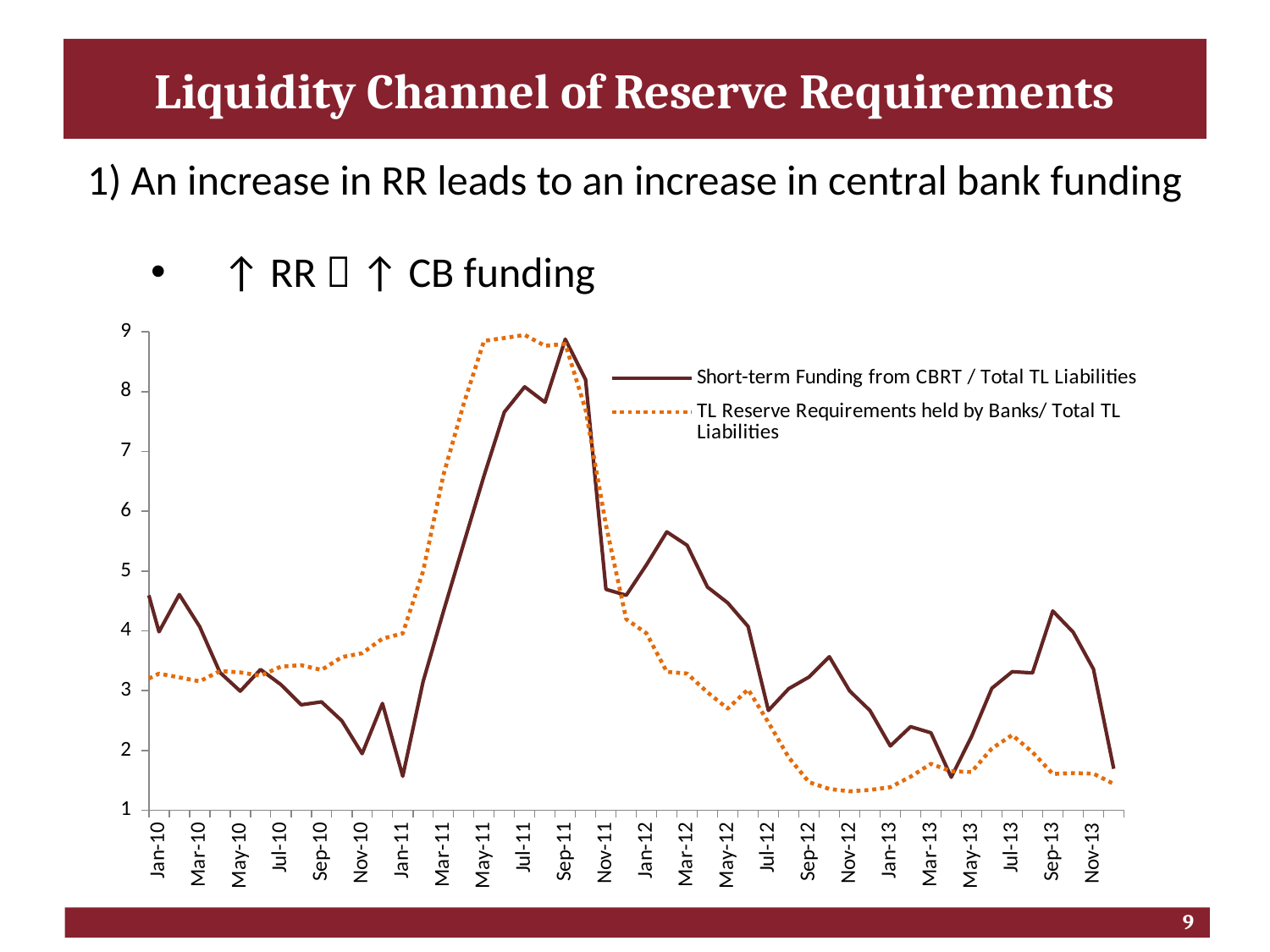
What kind of chart is shown on the slide? Line chart What is the first label on the x axis of the chart? Jan-10 At Sep-12, which series has the higher value: Short-term Funding from CBRT / Total TL Liabilities or TL Reserve Requirements held by Banks/ Total TL Liabilities? Short-term Funding from CBRT / Total TL Liabilities Which series is drawn with a dotted line? TL Reserve Requirements held by Banks/ Total TL Liabilities How many series does the chart's legend list? 2 Is the value of TL Reserve Requirements held by Banks/ Total TL Liabilities at Nov-13 greater or less than 2? less Is the value of TL Reserve Requirements held by Banks/ Total TL Liabilities at Jul-11 greater or less than 8? greater Is the value of Short-term Funding from CBRT / Total TL Liabilities at Jan-11 greater or less than 2? less Does the TL Reserve Requirements held by Banks/ Total TL Liabilities series rise or fall between Jan-11 and Jul-11? rise Does the Short-term Funding from CBRT / Total TL Liabilities series rise or fall between Sep-11 and Nov-11? fall At Jan-10, which series has the higher value: Short-term Funding from CBRT / Total TL Liabilities or TL Reserve Requirements held by Banks/ Total TL Liabilities? Short-term Funding from CBRT / Total TL Liabilities